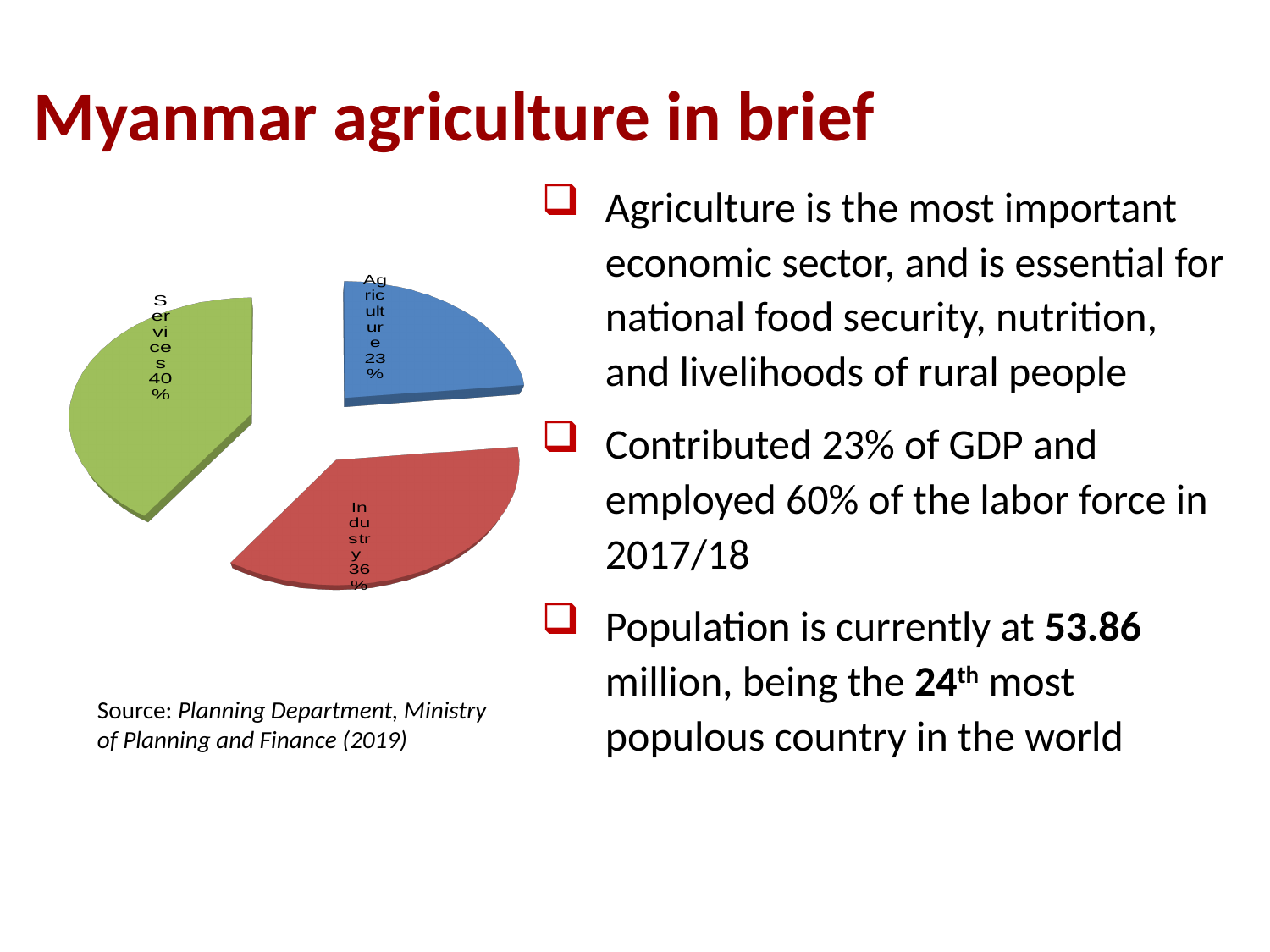
What colour is the Services slice in the pie chart? Green Which sector has the smallest slice in the pie chart? Agriculture What is the difference in percentage points between the Industry slice and the Agriculture slice? 13 What colour is the Industry slice in the pie chart? Red What share of the pie chart does Services account for? 40% Which is larger in the pie chart, Industry or Agriculture? Industry What kind of chart is shown on the slide? Pie chart What is the difference in percentage points between the Services slice and the Agriculture slice? 17 What share of the pie chart does Industry account for? 36% What share of the pie chart does Agriculture account for? 23% How many slices does the pie chart have? 3 Which sector has the largest slice in the pie chart? Services